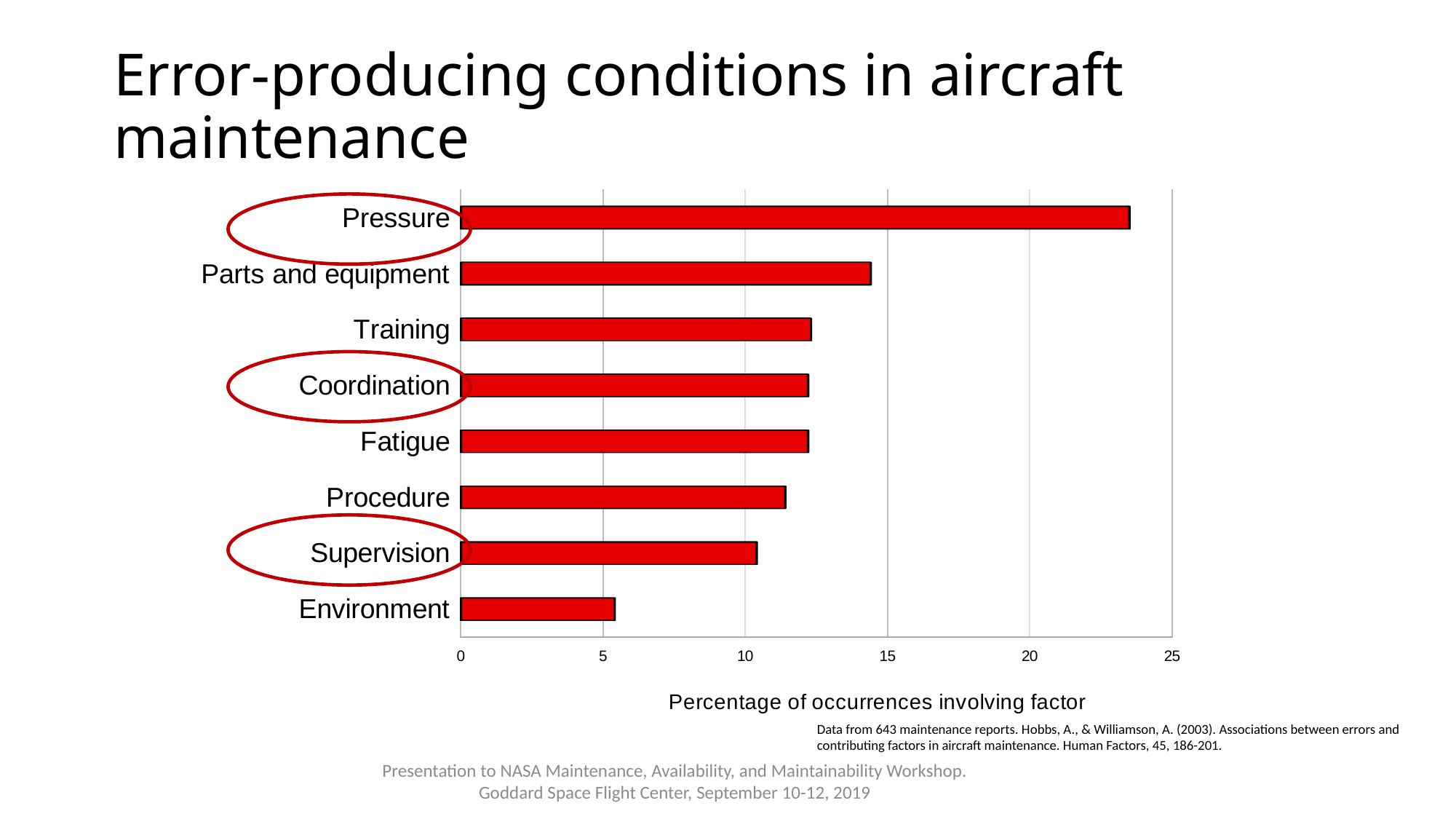
Is the value for Training greater or less than 10? greater Is the value for Pressure greater or less than 20? greater Which category has the highest percentage of occurrences involving the factor? Pressure Which is larger, the value for Parts and equipment or the value for Training? Parts and equipment Which is larger, the value for Pressure or the value for Parts and equipment? Pressure What is the label of the horizontal axis? Percentage of occurrences involving factor Is the value for Environment greater or less than 10? less How many categories are plotted in the chart? 8 Which three category labels are circled in red on the chart? Pressure, Coordination, Supervision Which category has the lowest percentage of occurrences involving the factor? Environment What kind of chart is shown on the slide? bar chart